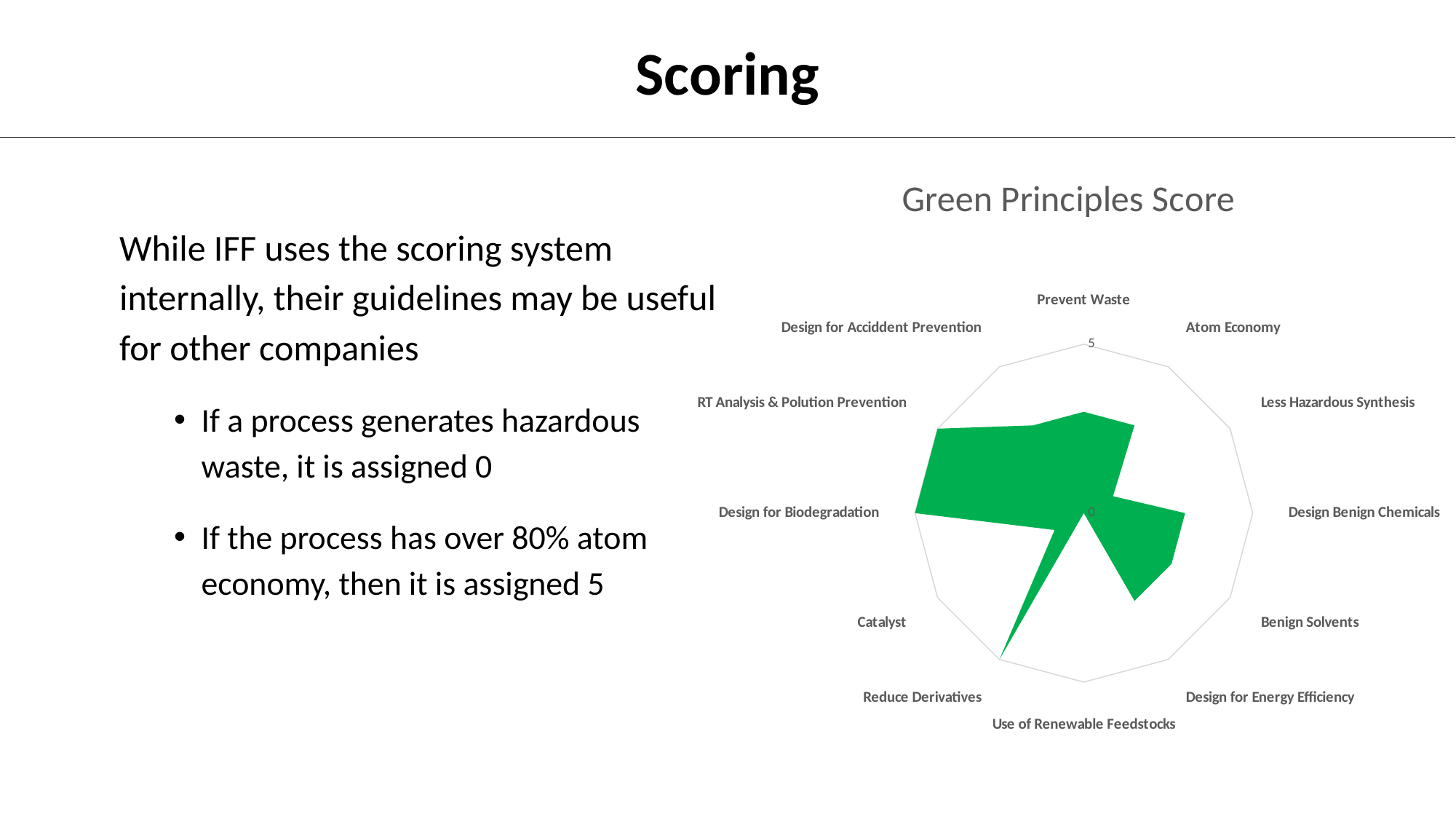
Which has the larger value, Design for Biodegradation or Prevent Waste? Design for Biodegradation Is the value for Prevent Waste greater or less than 0? greater Which has the larger value, Reduce Derivatives or Use of Renewable Feedstocks? Reduce Derivatives Which has the larger value, Prevent Waste or Catalyst? Prevent Waste Is the value for Design Benign Chemicals greater or less than 5? less Is the value for Prevent Waste greater or less than 5? less How many categories (principles) are plotted on the radar chart? 12 What is the title of the chart? Green Principles Score What kind of chart is shown on the slide? Radar chart What colour is the filled area of the radar chart? Green